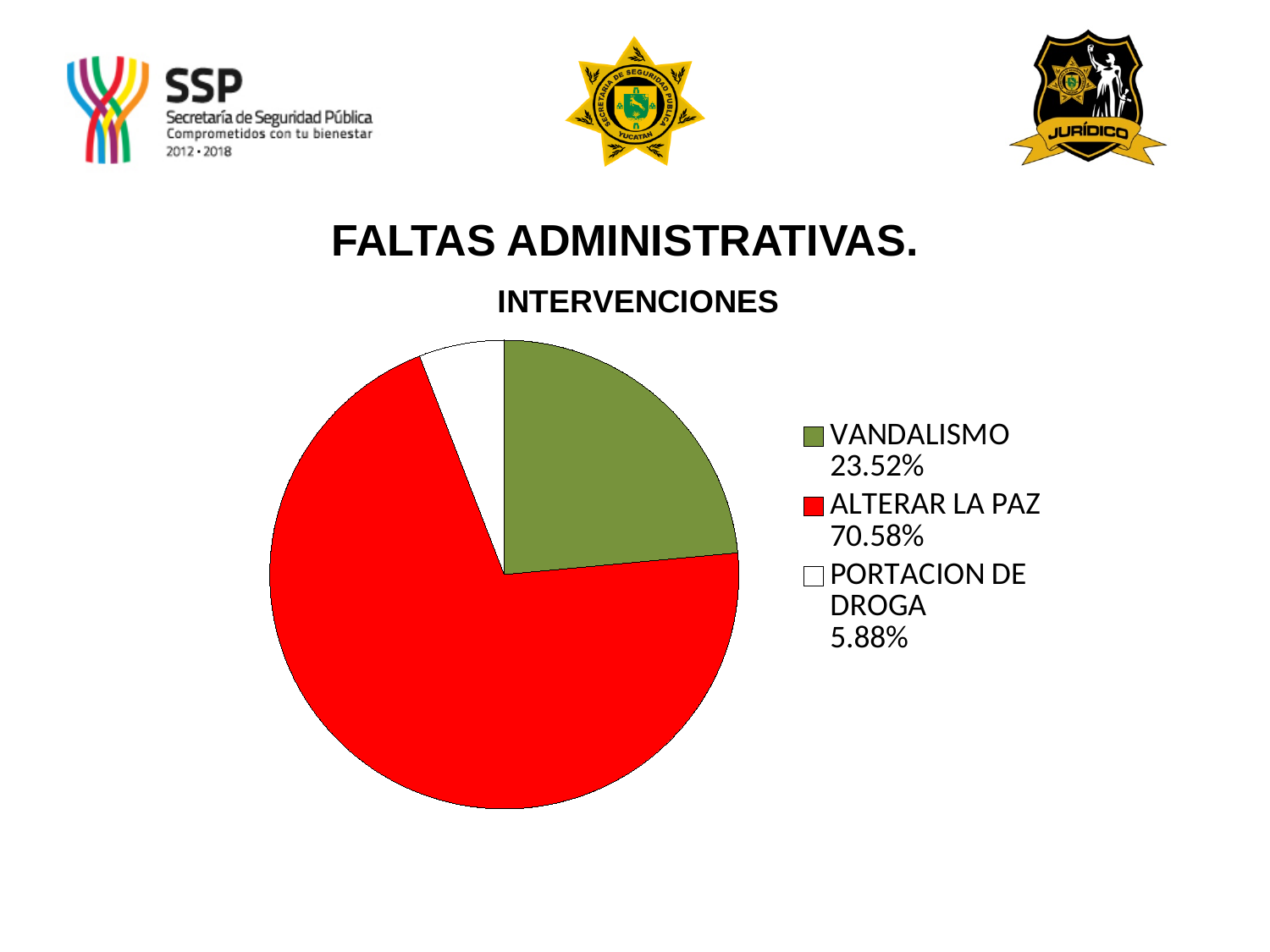
What is the title of the chart? INTERVENCIONES What is the difference in percentage points between ALTERAR LA PAZ and VANDALISMO? 47.06 What is the difference in percentage points between VANDALISMO and PORTACION DE DROGA? 17.64 Which category has the smallest slice of the pie? PORTACION DE DROGA What share of the pie does PORTACION DE DROGA represent? 5.88% Which is larger, the share for VANDALISMO or the share for PORTACION DE DROGA? VANDALISMO What colour is the slice for ALTERAR LA PAZ? red What share of the pie does VANDALISMO represent? 23.52% Which category has the largest slice of the pie? ALTERAR LA PAZ What kind of chart is shown on the slide? pie chart What share of the pie does ALTERAR LA PAZ represent? 70.58% How many slices does the pie chart have? 3